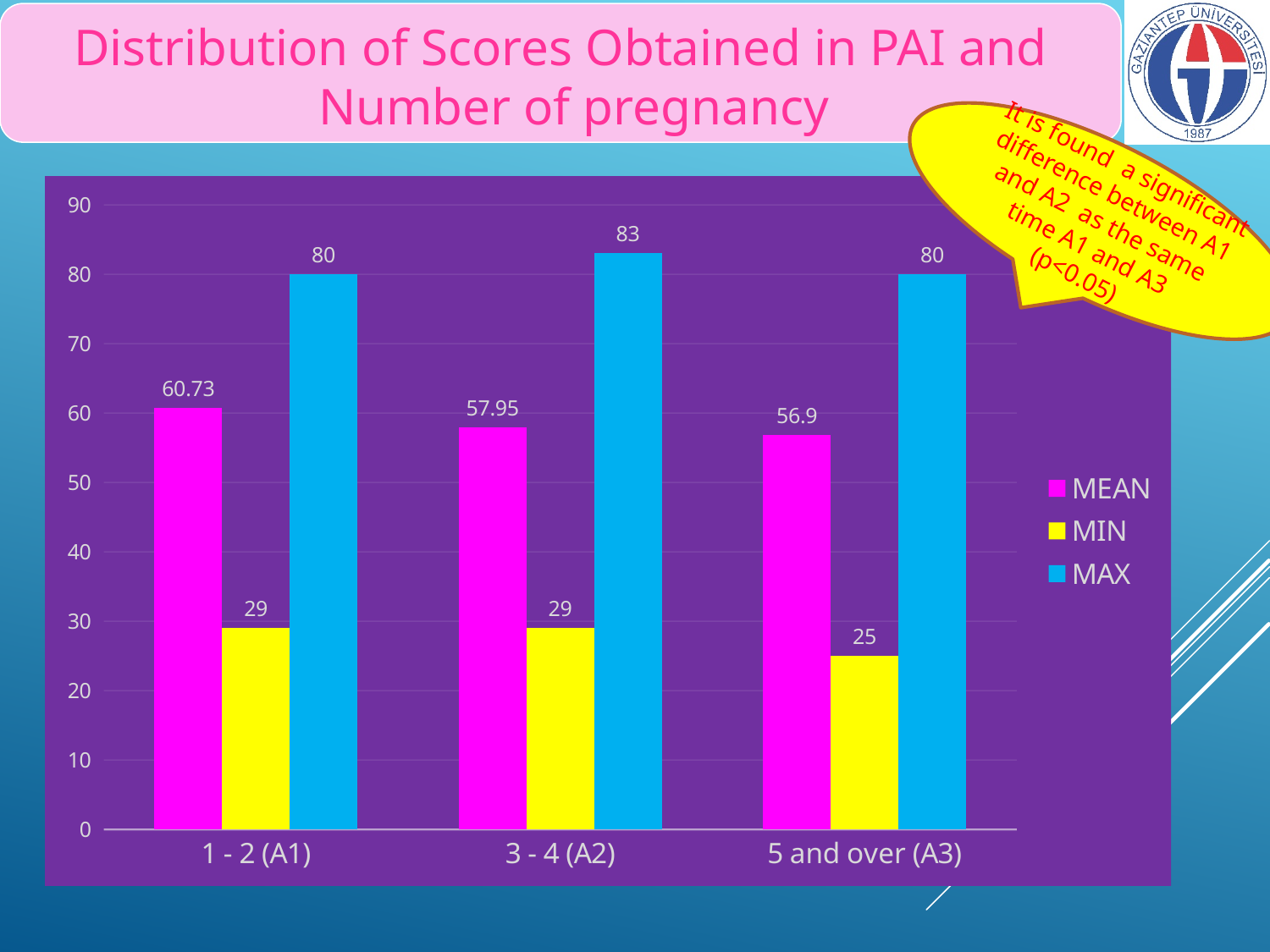
How many series does the legend list? 3 What is the difference between the MAX value and the MIN value for the 3 - 4 (A2) group? 54 What kind of chart is shown on the slide? Bar chart Do the MEAN values rise or fall from 1 - 2 (A1) to 5 and over (A3)? Fall What is the MIN value for the 5 and over (A3) group? 25 Which is larger, the MAX value for 3 - 4 (A2) or the MAX value for 5 and over (A3)? 3 - 4 (A2) What is the MEAN value for the 1 - 2 (A1) group? 60.73 How many pregnancy groups are shown on the x axis? 3 Which group has the lowest MIN value? 5 and over (A3) Which group has the highest MEAN value? 1 - 2 (A1) What is the difference between the MEAN values of the 1 - 2 (A1) and 5 and over (A3) groups? 3.83 What is the MAX value for the 3 - 4 (A2) group? 83